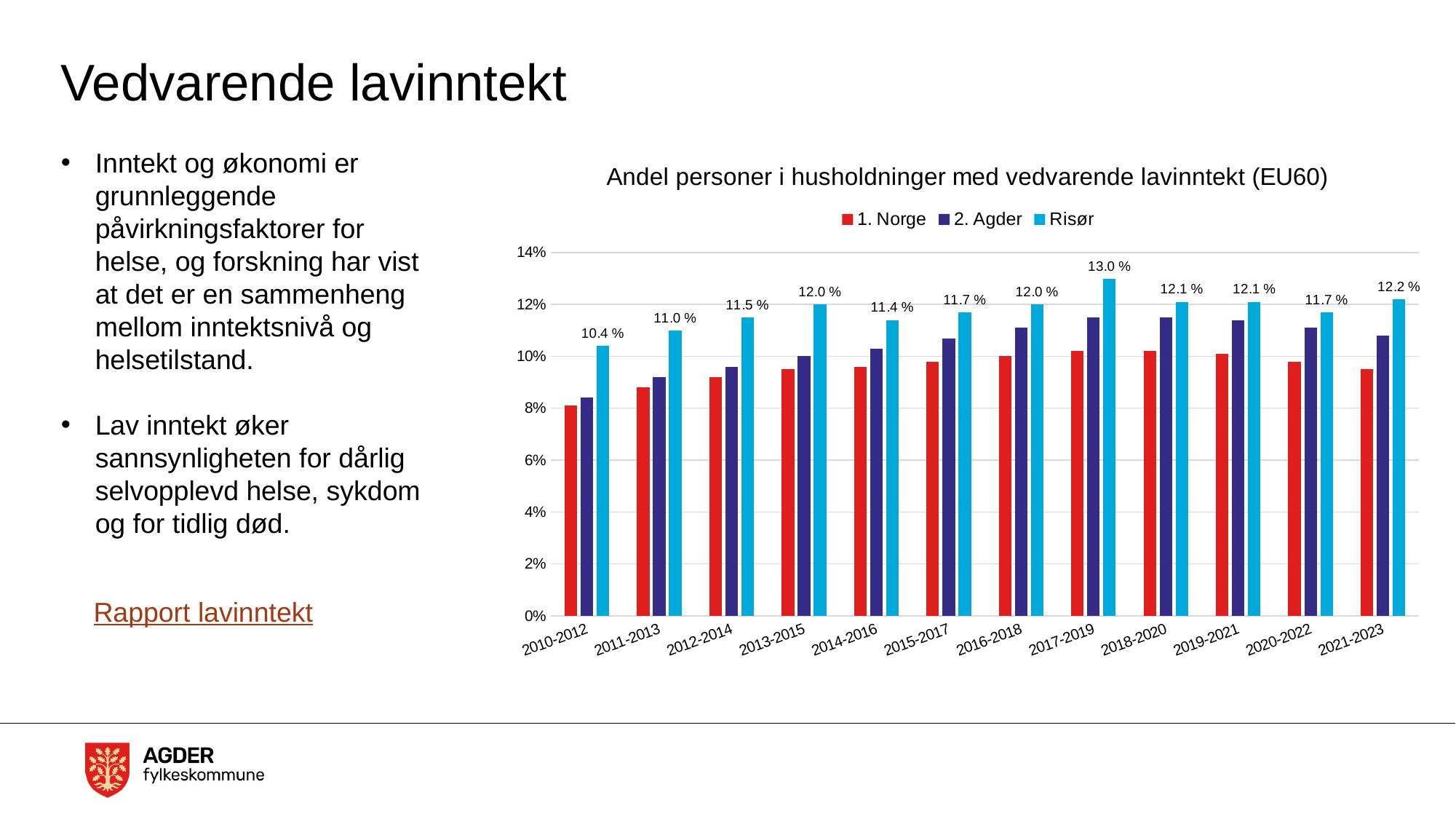
How many series does the legend list? 3 In which period is the Risør value lowest? 2010-2012 Is the value for 1. Norge in 2010-2012 greater or less than 10%? less How many periods are shown on the x axis? 12 What is the value for Risør in 2017-2019? 13.0 % In 2017-2019, which is larger: the value for Risør or the value for 1. Norge? Risør Is the value for 2. Agder in 2021-2023 greater or less than 10%? greater What is the difference between the Risør value in 2017-2019 and in 2010-2012? 2.6 percentage points What kind of chart is shown on the slide? Bar chart In which period is the Risør value highest? 2017-2019 What is the value for Risør in 2021-2023? 12.2 % What is the value for Risør in 2010-2012? 10.4 %